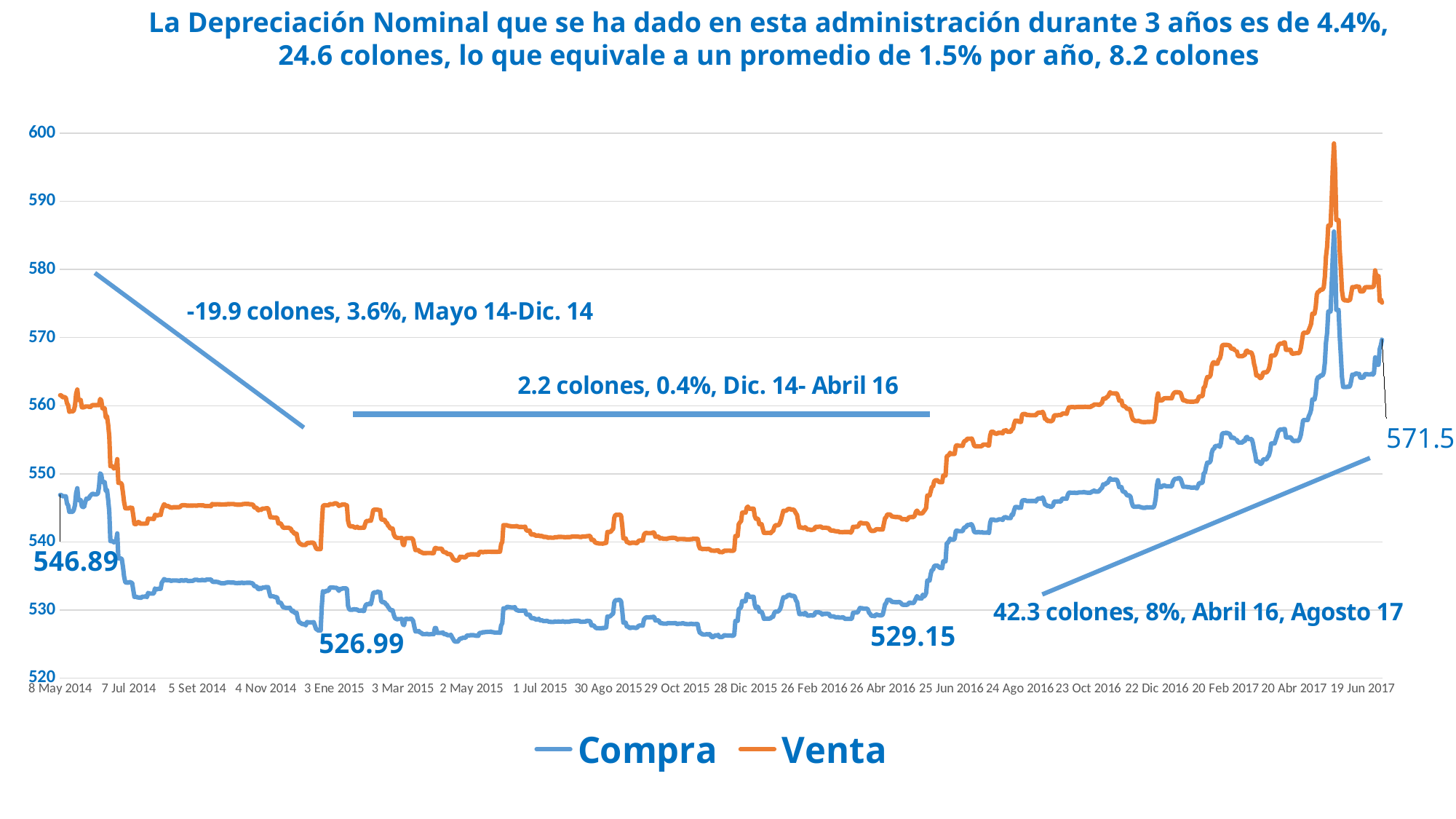
Do the Compra and Venta values rise or fall between April 2016 and August 2017? rise What is the labeled value of the Compra series at the end of the chart? 571.5 Which series is plotted higher throughout the chart, Compra or Venta? Venta What colour is the Venta series line? orange What is the difference between the labeled values 529.15 and 526.99 on the Compra series? 2.16 Is the lowest point of the Compra series (around May 2015) greater or less than 530? less What is the difference between the final labeled Compra value (571.5) and the initial labeled value (546.89)? 24.61 What kind of chart is shown on the slide? line chart How many series does the legend list? 2 What is the lowest labeled value shown on the Compra series? 526.99 What is the labeled value of the Compra series at the start of the chart (8 May 2014)? 546.89 Is the peak value of the Venta series (around June 2017) greater or less than 590? greater